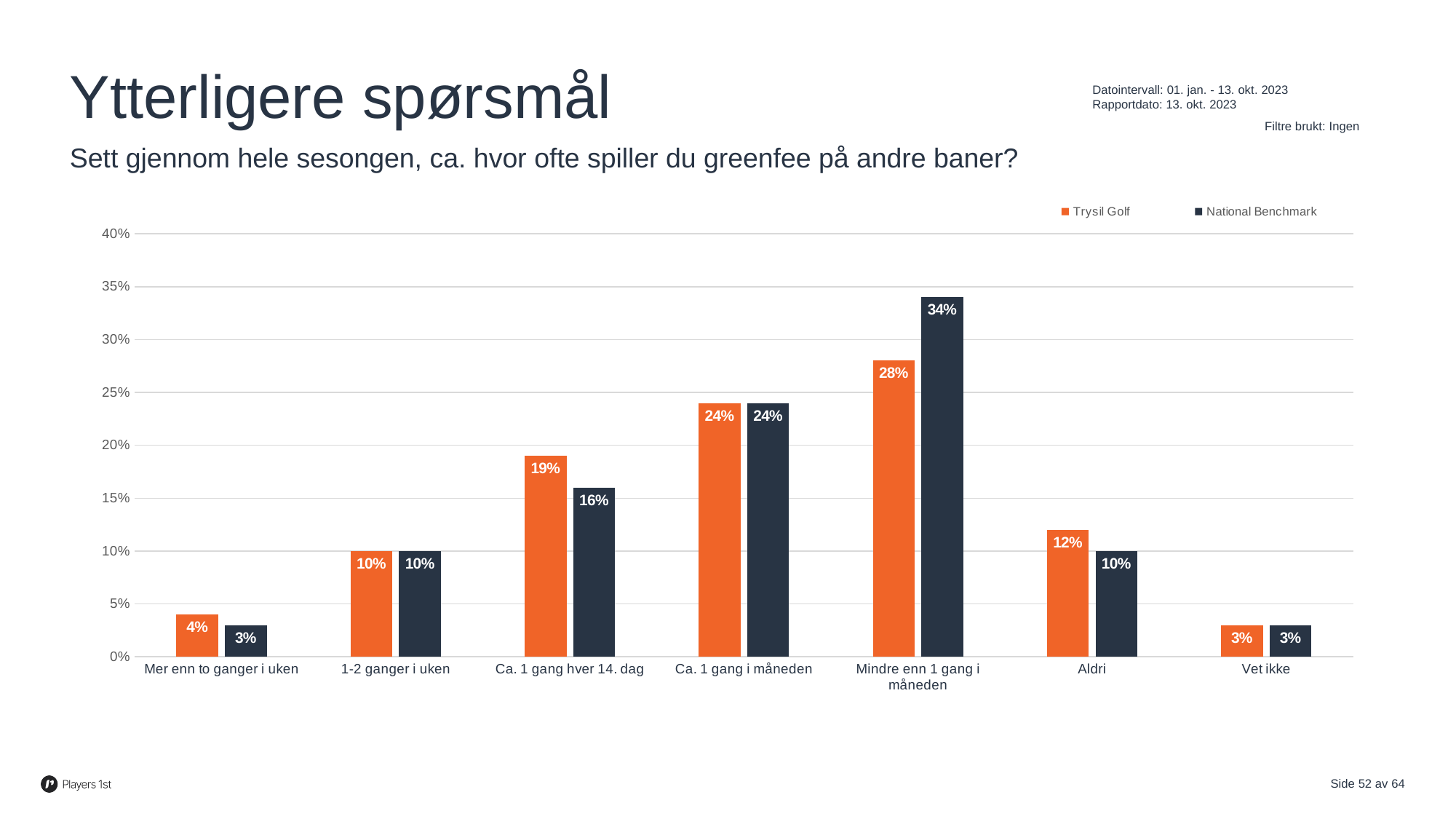
What is the National Benchmark value for "Mindre enn 1 gang i måneden"? 34% Which colour represents Trysil Golf in the chart? Orange What is the difference between the Trysil Golf and National Benchmark values for "Mindre enn 1 gang i måneden"? 6% What kind of chart is shown on the slide? Bar chart Is the National Benchmark value for "Mindre enn 1 gang i måneden" greater or less than 30%? greater How many series does the legend list? 2 What is the Trysil Golf value for "Aldri"? 12% Which is larger for "Ca. 1 gang hver 14. dag": Trysil Golf or National Benchmark? Trysil Golf How many categories are shown on the x axis? 7 Which category has the highest National Benchmark value? Mindre enn 1 gang i måneden What is the Trysil Golf value for "Ca. 1 gang hver 14. dag"? 19% Which category has the lowest Trysil Golf value? Vet ikke